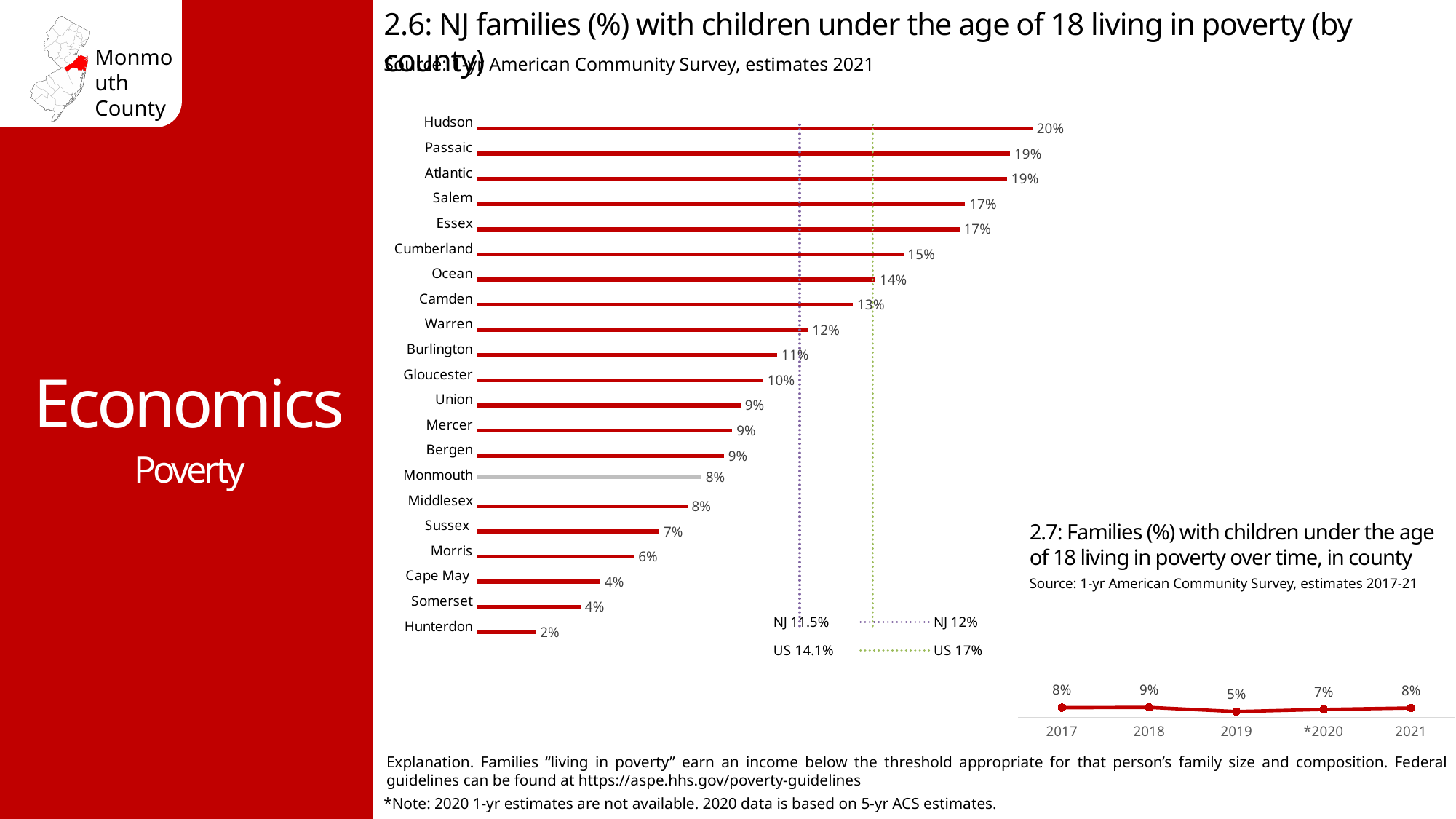
In chart 2.6, which has a higher value, Ocean or Camden? Ocean In chart 2.6, what is the difference between the values for Hudson and Hunterdon? 18% In chart 2.7, which year has the highest value? 2018 In chart 2.7, how many years are plotted? 5 In chart 2.6, how many counties are plotted? 21 In chart 2.6, what is the value for Cumberland? 15% In chart 2.6, which county has the highest percentage of families with children living in poverty? Hudson In chart 2.6 (NJ families with children under 18 living in poverty by county), what is the value for Monmouth? 8% In chart 2.6, which county has the lowest percentage of families with children living in poverty? Hunterdon What kind of chart is chart 2.6? Bar chart In chart 2.7 (families with children under 18 living in poverty over time, in county), what is the value for 2019? 5%